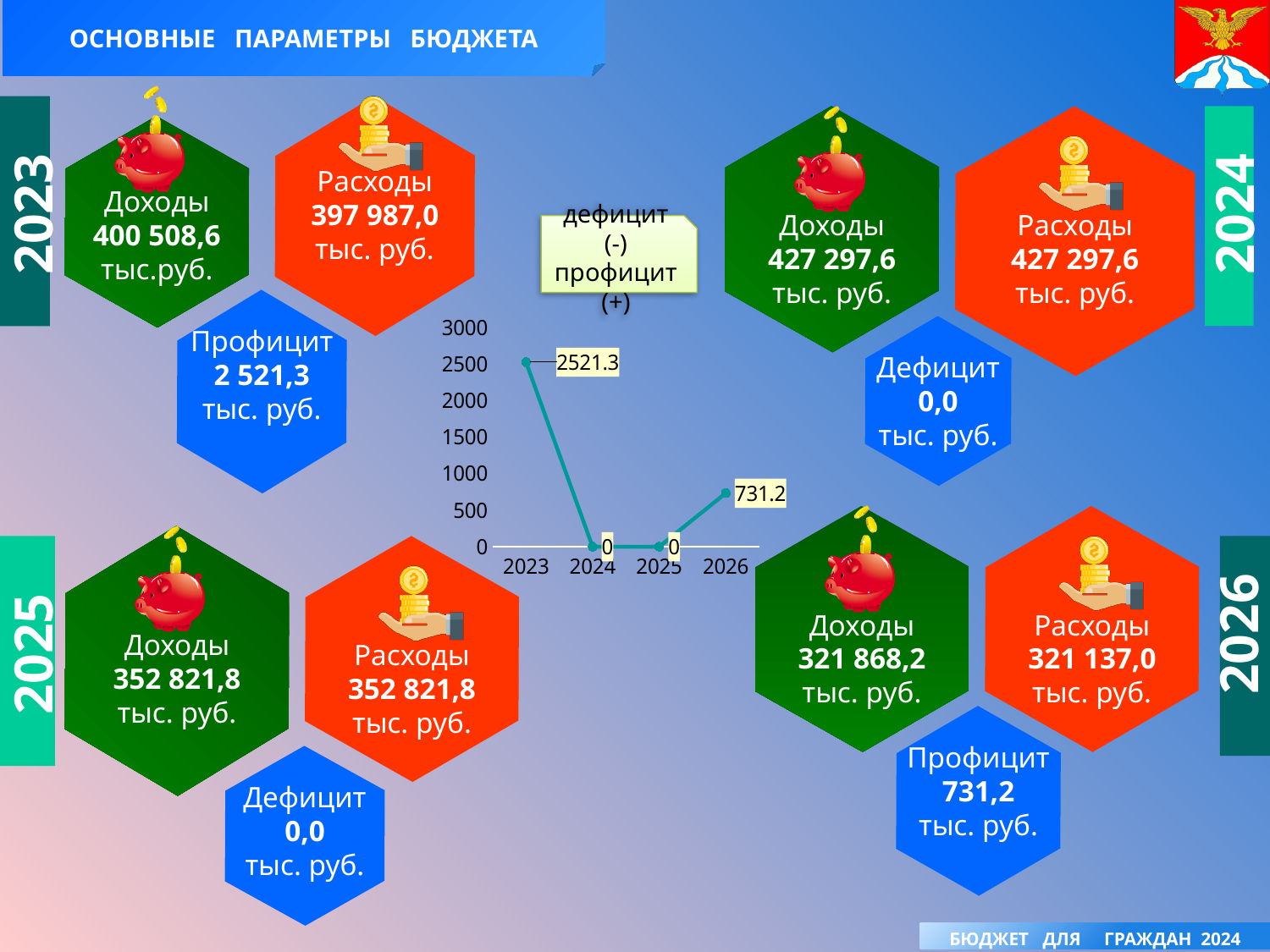
What is the maximum value shown on the y axis of the line chart? 3000 Does the line fall or rise from 2023 to 2024 in the line chart? fall What is the value plotted for 2026 in the line chart? 731.2 How many years are plotted on the x axis of the line chart? 4 Which year has the highest value in the line chart? 2023 What is the difference between the values for 2023 and 2026 in the line chart? 1790.1 What type of chart is shown on the slide? line chart Is the value for 2026 in the line chart greater or less than 1000? less What is the value plotted for 2023 in the line chart? 2521.3 What is the value plotted for 2024 in the line chart? 0 Which is larger in the line chart, the value for 2023 or the value for 2026? 2023 What is the value plotted for 2025 in the line chart? 0